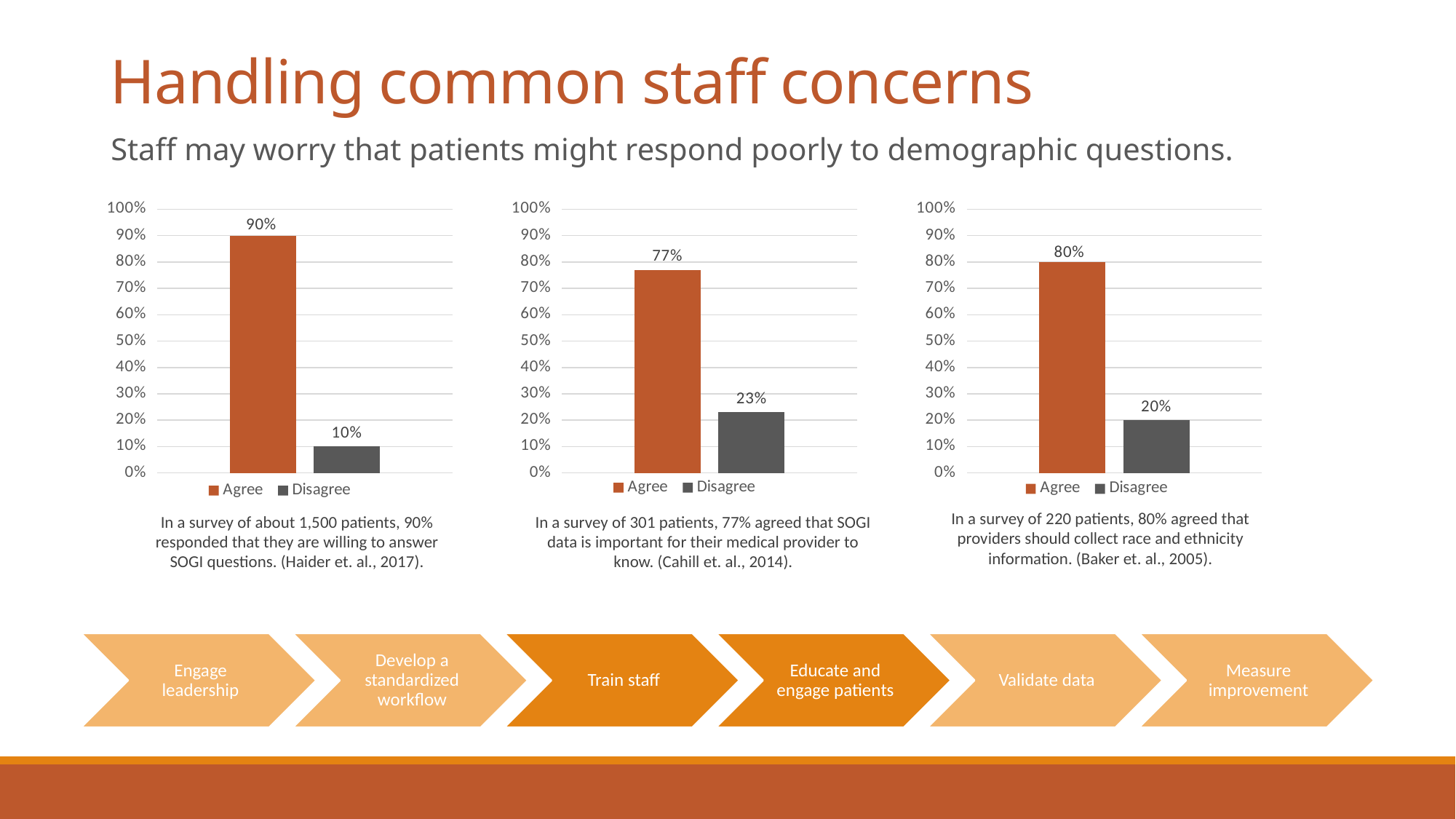
In the middle chart, what is the value for Agree? 77% In the left chart, what is the value for Agree? 90% In the right chart, what is the value for Disagree? 20% What kind of chart is the left chart? Bar chart In the right chart, what is the value for Agree? 80% In the middle chart, what is the difference between Agree and Disagree? 54% In the right chart, what colour is the Agree bar? Orange In the left chart, which series has the lowest value? Disagree In the left chart, what is the value for Disagree? 10% In the right chart, which is larger, Agree or Disagree? Agree In the middle chart, what is the value for Disagree? 23% How many series does the legend of the middle chart list? 2